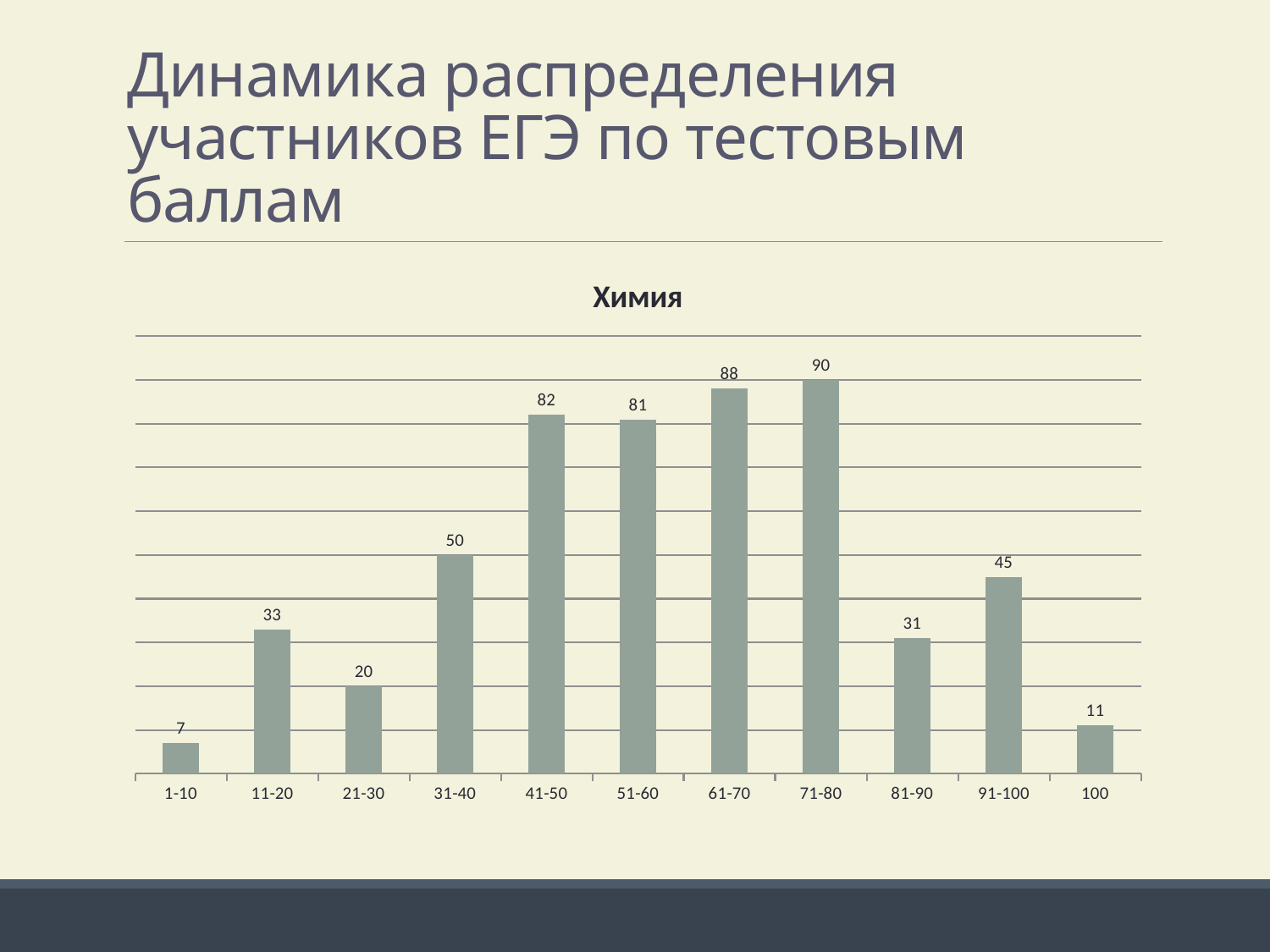
What is the value for the 100 category? 11 What is the value for the 41-50 score range? 82 Which is larger, the value for 11-20 or the value for 81-90? 11-20 What is the difference between the values for 31-40 and 21-30? 30 What kind of chart is shown on the slide? Bar chart Which score range has the lowest value? 1-10 Which score range has the highest value? 71-80 Do the values rise or fall from the 1-10 category to the 71-80 category? Rise What is the value for the 91-100 score range? 45 What is the difference between the values for 71-80 and 81-90? 59 What is the title of the chart? Химия How many score-range categories are shown on the x axis? 11